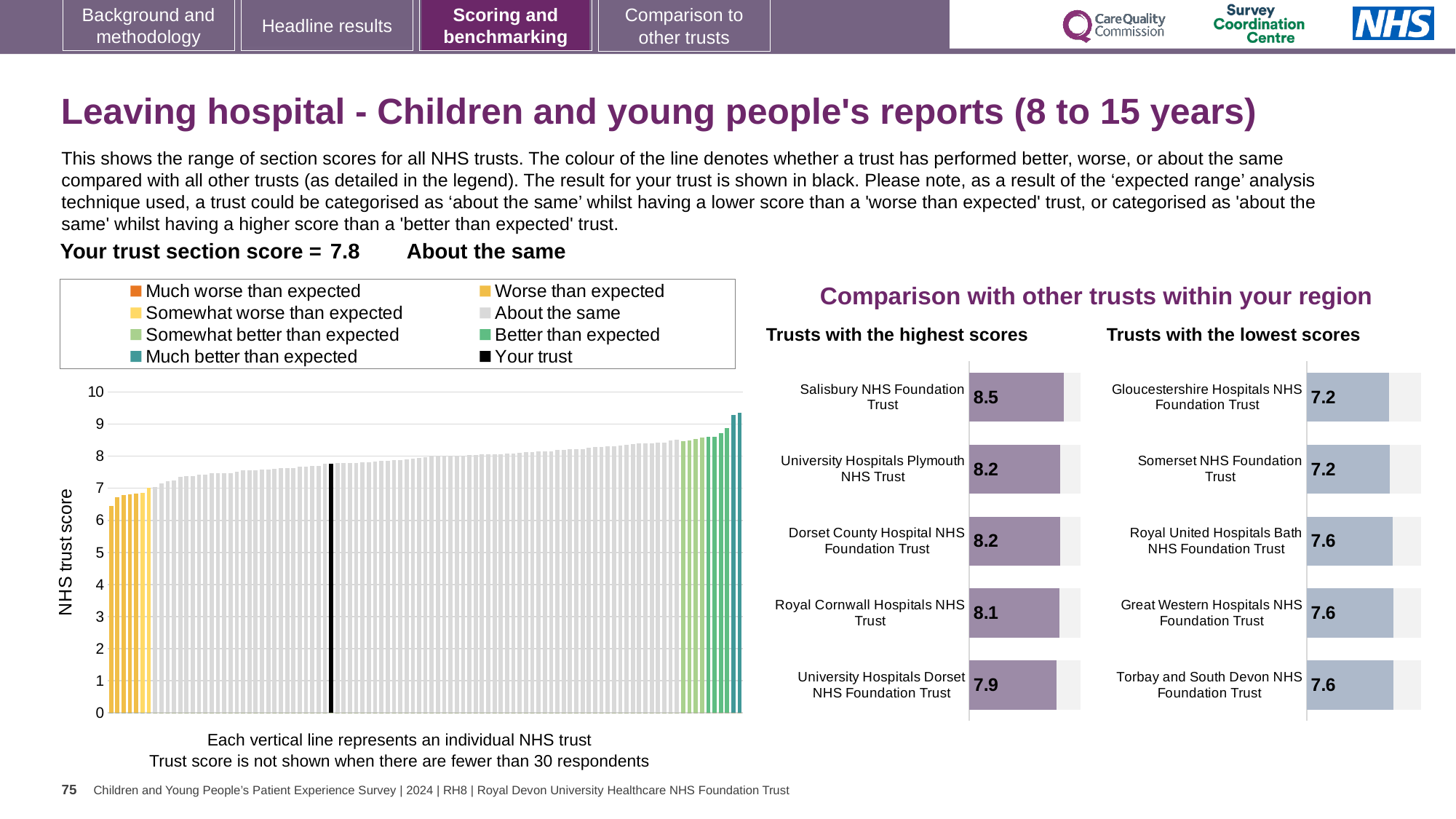
On the main chart on the left, do the bar values rise or fall from left to right? rise On the 'Trusts with the highest scores' chart, what is the score for Salisbury NHS Foundation Trust? 8.5 On the 'Trusts with the lowest scores' chart, what is the score for Royal United Hospitals Bath NHS Foundation Trust? 7.6 On the 'Trusts with the highest scores' chart, what is the difference between the scores of Salisbury NHS Foundation Trust and University Hospitals Dorset NHS Foundation Trust? 0.6 Which is larger: the score for Royal Cornwall Hospitals NHS Trust on the highest scores chart or the score for Gloucestershire Hospitals NHS Foundation Trust on the lowest scores chart? Royal Cornwall Hospitals NHS Trust On the 'Trusts with the highest scores' chart, which trust has the highest score? Salisbury NHS Foundation Trust On the main chart on the left showing the range of section scores, what is the section score for your trust (the black bar)? 7.8 On the 'Trusts with the highest scores' chart, what is the score for University Hospitals Dorset NHS Foundation Trust? 7.9 How many entries does the legend above the main chart on the left list? 8 On the 'Trusts with the lowest scores' chart, what is the difference between the scores of Torbay and South Devon NHS Foundation Trust and Somerset NHS Foundation Trust? 0.4 How many trusts are shown on the 'Trusts with the lowest scores' chart? 5 On the main chart on the left, is the value of the lowest (leftmost) bar greater or less than 7? less